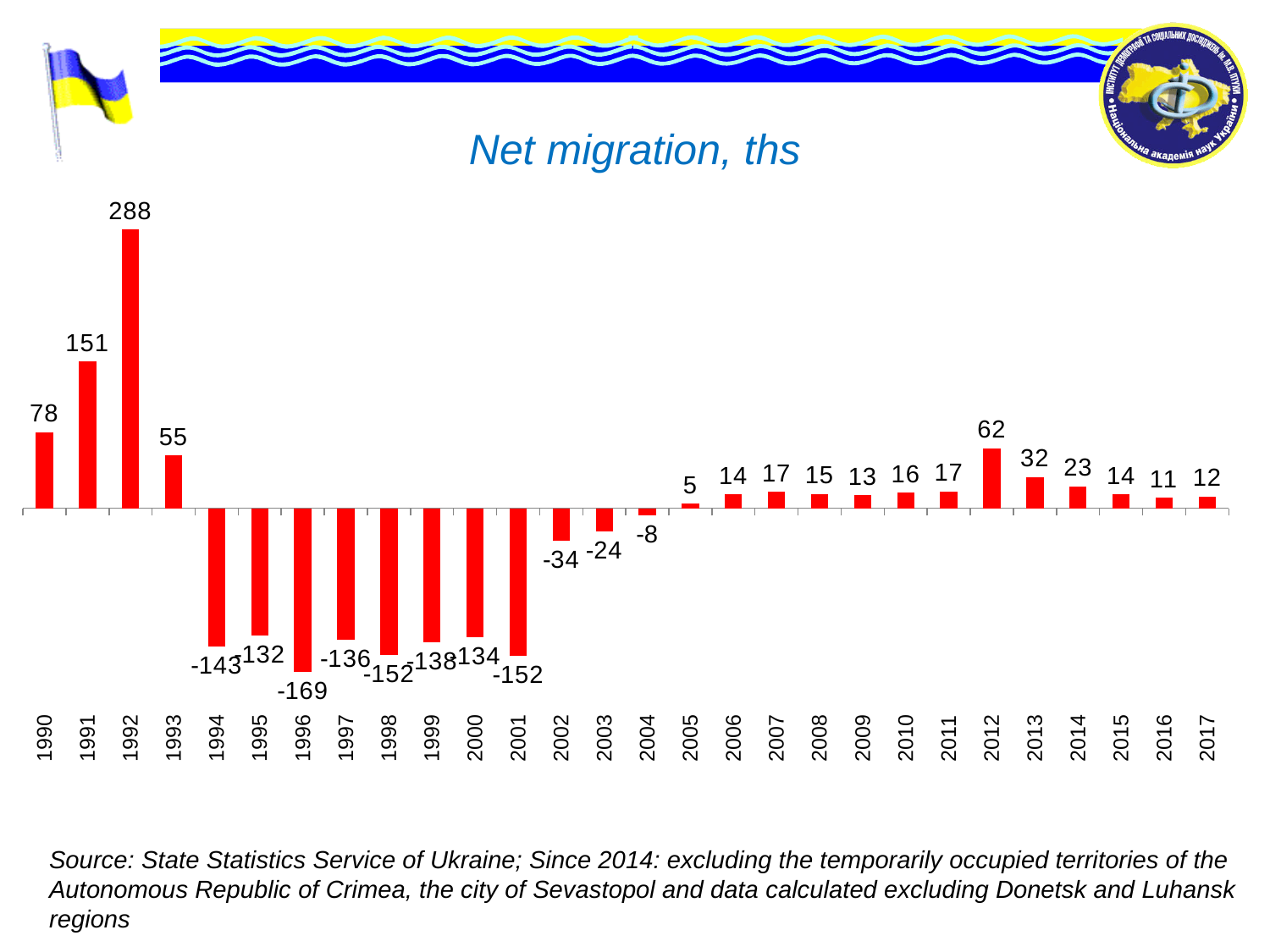
How many years are shown on the x axis of the chart? 28 Which year has the lowest net migration? 1996 What is the net migration value for 2017? 12 Which year has a larger net migration value, 2013 or 2014? 2013 What is the net migration value for 2012? 62 Do the net migration values rise or fall from 1990 to 1992? Rise Which year has the highest net migration? 1992 What is the difference between the net migration values for 1992 and 1991? 137 What is the net migration value for 1992? 288 What is the net migration value for 1996? -169 What kind of chart is shown on the slide? Bar chart What is the title of the chart? Net migration, ths